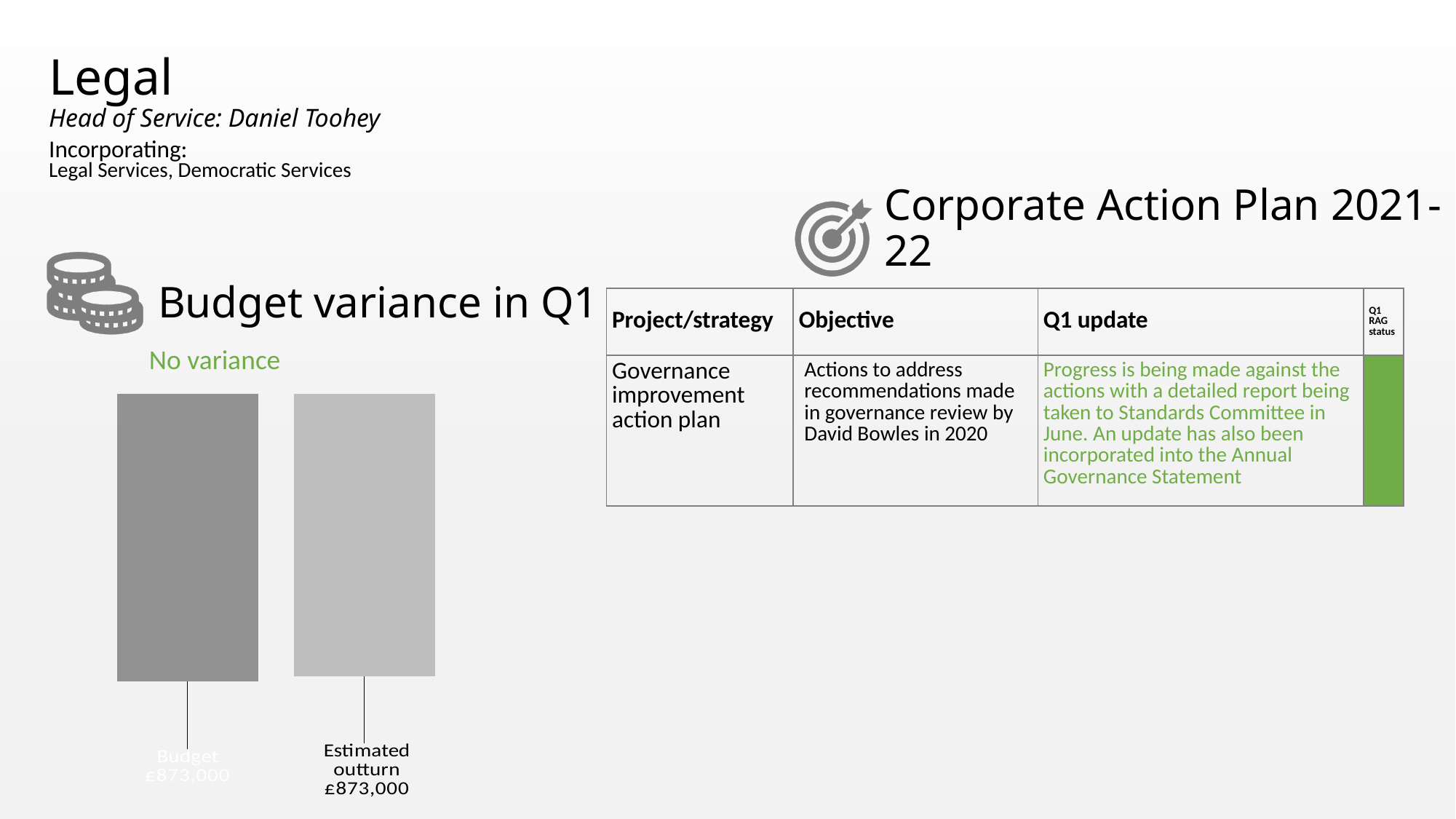
How many bars are shown in the Budget variance in Q1 chart? 2 What is the value of the Budget bar in the Budget variance in Q1 chart? £873,000 What is the title of the chart on the left of the slide? Budget variance in Q1 What are the two category labels in the Budget variance in Q1 chart? Budget and Estimated outturn What is the difference between the Budget and the Estimated outturn in the Budget variance in Q1 chart? £0 Is the Estimated outturn in the Budget variance in Q1 chart greater than, less than, or equal to the Budget? Equal What is the value of the Estimated outturn bar in the Budget variance in Q1 chart? £873,000 What kind of chart is used to show the budget variance in Q1? Bar chart What variance note is printed in green above the Budget variance in Q1 chart? No variance